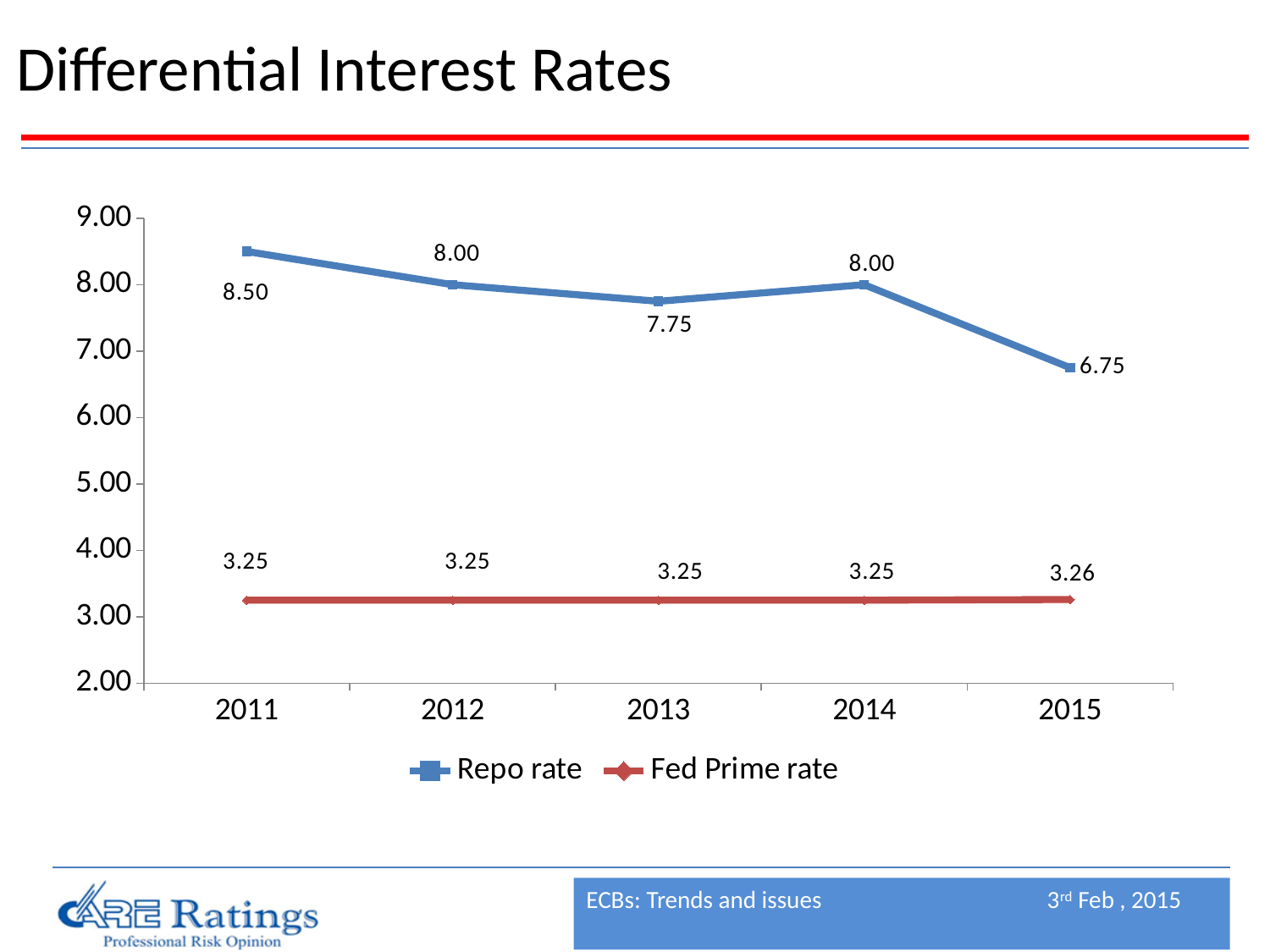
What is the Repo rate in 2011? 8.50 What is the Repo rate in 2015? 6.75 How many years are shown on the x axis? 5 What is the Fed Prime rate in 2015? 3.26 Which is larger in 2012, the Repo rate or the Fed Prime rate? Repo rate In which year is the Repo rate highest? 2011 By how much did the Repo rate fall from 2014 to 2015? 1.25 What is the Repo rate in 2013? 7.75 What kind of chart is shown on the slide? Line chart What is the difference between the Repo rate and the Fed Prime rate in 2014? 4.75 In which year is the Repo rate lowest? 2015 How many series does the legend list? 2